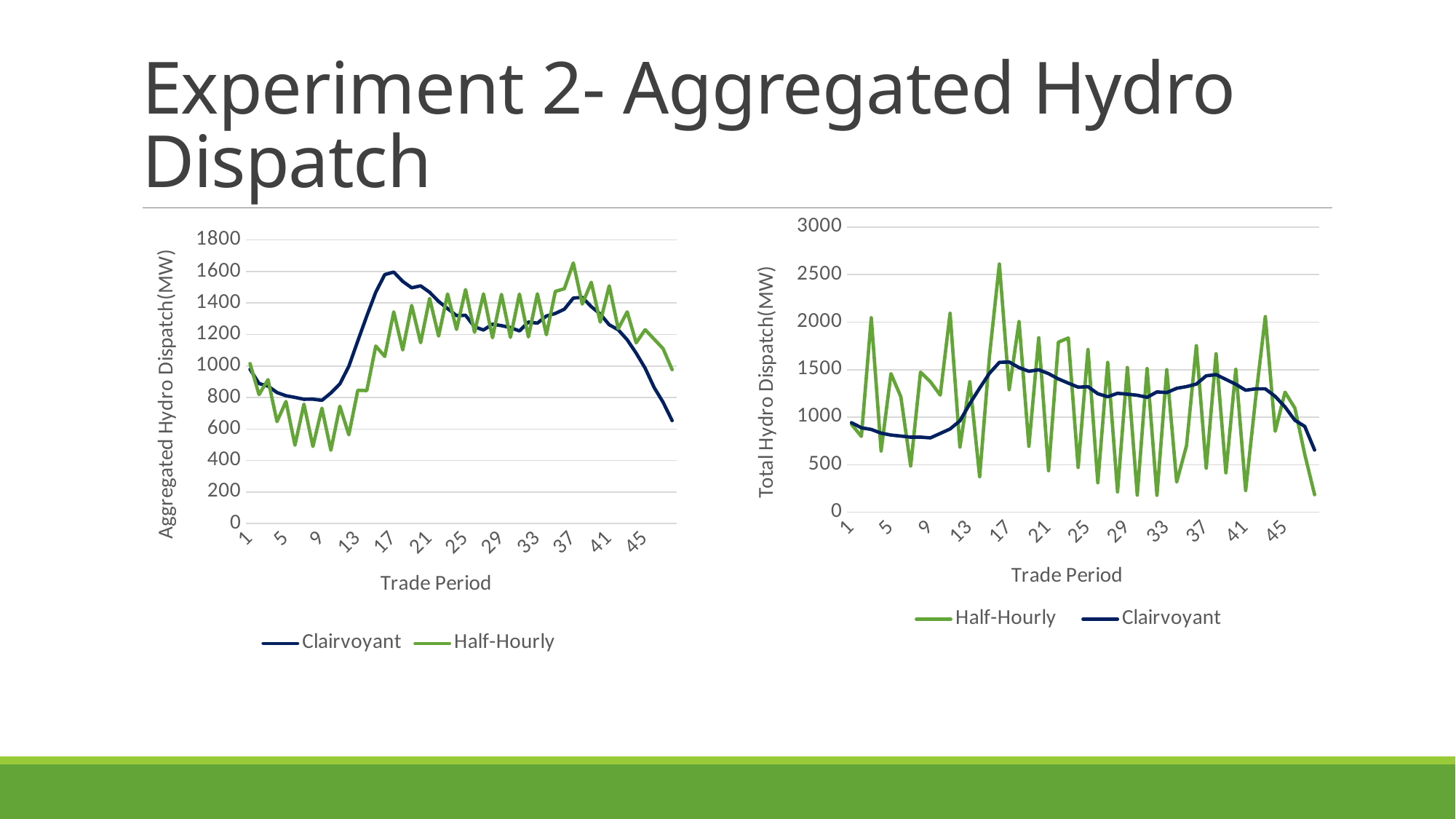
In the right chart (Total Hydro Dispatch), does the Clairvoyant line rise or fall from trade period 9 to trade period 17? rise In the right chart (Total Hydro Dispatch), is the Clairvoyant value at the last trade period greater or less than 1000? less In the right chart (Total Hydro Dispatch), which series reaches the highest value anywhere on the chart? Half-Hourly What are the two series named in the legend of the left chart (Aggregated Hydro Dispatch)? Clairvoyant and Half-Hourly In the left chart (Aggregated Hydro Dispatch), at trade period 17, which series has the larger value, Clairvoyant or Half-Hourly? Clairvoyant In the left chart (Aggregated Hydro Dispatch), is the Clairvoyant value at trade period 17 greater or less than 1400? greater What kind of chart is the left chart, titled with the y-axis 'Aggregated Hydro Dispatch(MW)'? line chart In the left chart (Aggregated Hydro Dispatch), is the Clairvoyant value at trade period 9 greater or less than 1000? less What is the y-axis title of the right chart? Total Hydro Dispatch(MW) How many series does the legend of the right chart (Total Hydro Dispatch) list? 2 In the left chart (Aggregated Hydro Dispatch), does the Clairvoyant line rise or fall from trade period 41 to the end? fall